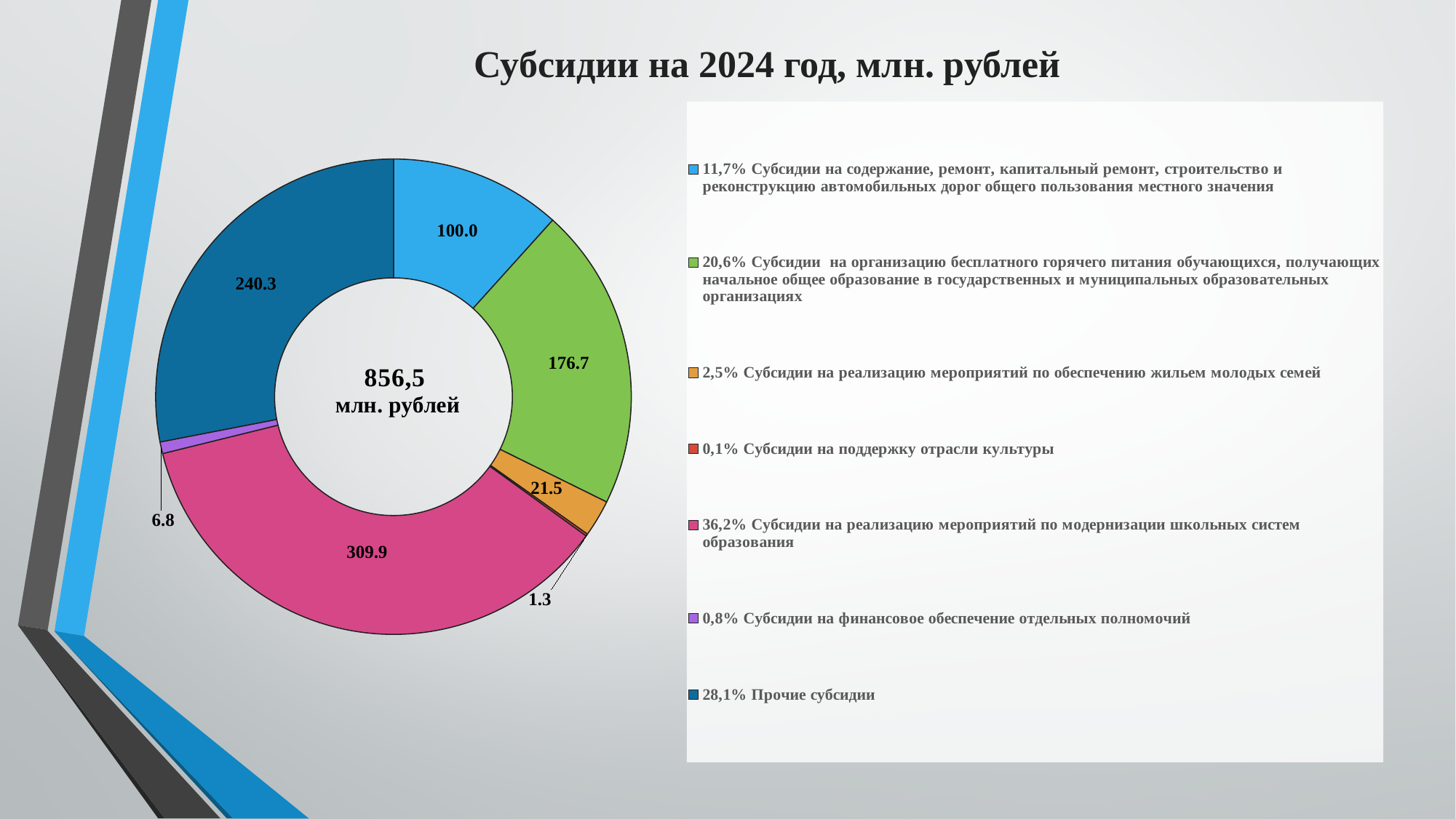
Which category has the smallest slice? Субсидии на поддержку отрасли культуры How many categories does the chart show? 7 What share of the total does "Субсидии на финансовое обеспечение отдельных полномочий" represent? 0,8% What kind of chart is shown on the slide? Doughnut (pie) chart Which is larger: the value for the road subsidies ("Субсидии на содержание, ремонт, капитальный ремонт, строительство и реконструкцию автомобильных дорог") or the value for the hot meals subsidies ("Субсидии на организацию бесплатного горячего питания")? Субсидии на организацию бесплатного горячего питания Which category has the largest slice? Субсидии на реализацию мероприятий по модернизации школьных систем образования What is the value for "Субсидии на реализацию мероприятий по обеспечению жильем молодых семей"? 21.5 What share of the total do "Прочие субсидии" represent? 28,1% What is the value for "Прочие субсидии"? 240.3 What is the value for "Субсидии на поддержку отрасли культуры"? 1.3 What total is shown in the centre of the doughnut chart? 856,5 млн. рублей What is the difference between the value for "Субсидии на реализацию мероприятий по модернизации школьных систем образования" and the value for "Прочие субсидии"? 69.6